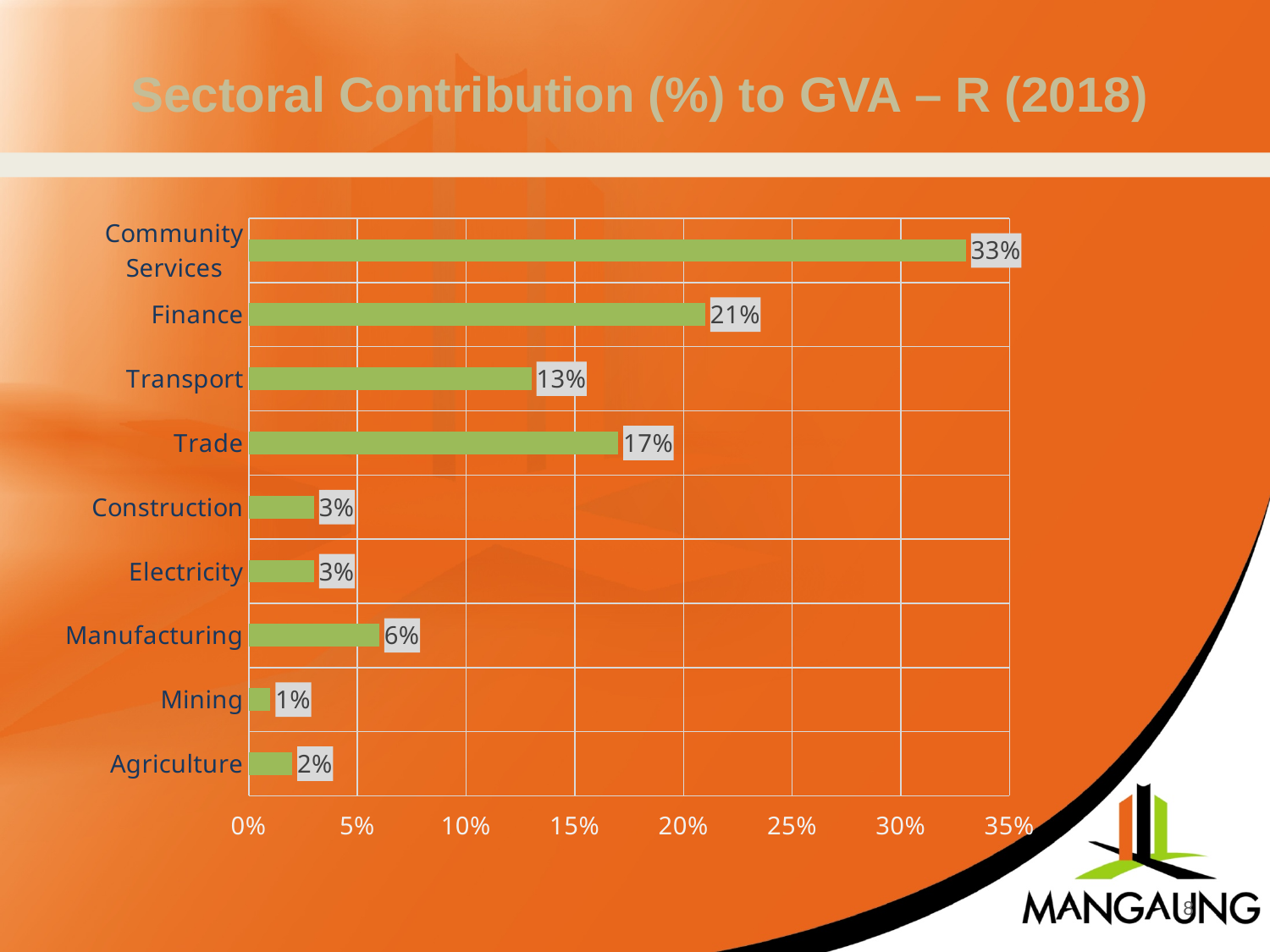
What is the difference between the values for Finance and Trade? 4% What is the value for Transport? 13% What is the title of the chart on the slide? Sectoral Contribution (%) to GVA – R (2018) Is the value for Community Services greater or less than 30%? greater Which sector has the highest contribution? Community Services What is the value for Finance? 21% How many sectors are shown in the chart? 9 What is the value for Community Services? 33% What kind of chart is shown on the slide? Bar chart Which sector has the lowest contribution? Mining What is the value for Manufacturing? 6% Which is larger, the value for Trade or the value for Transport? Trade